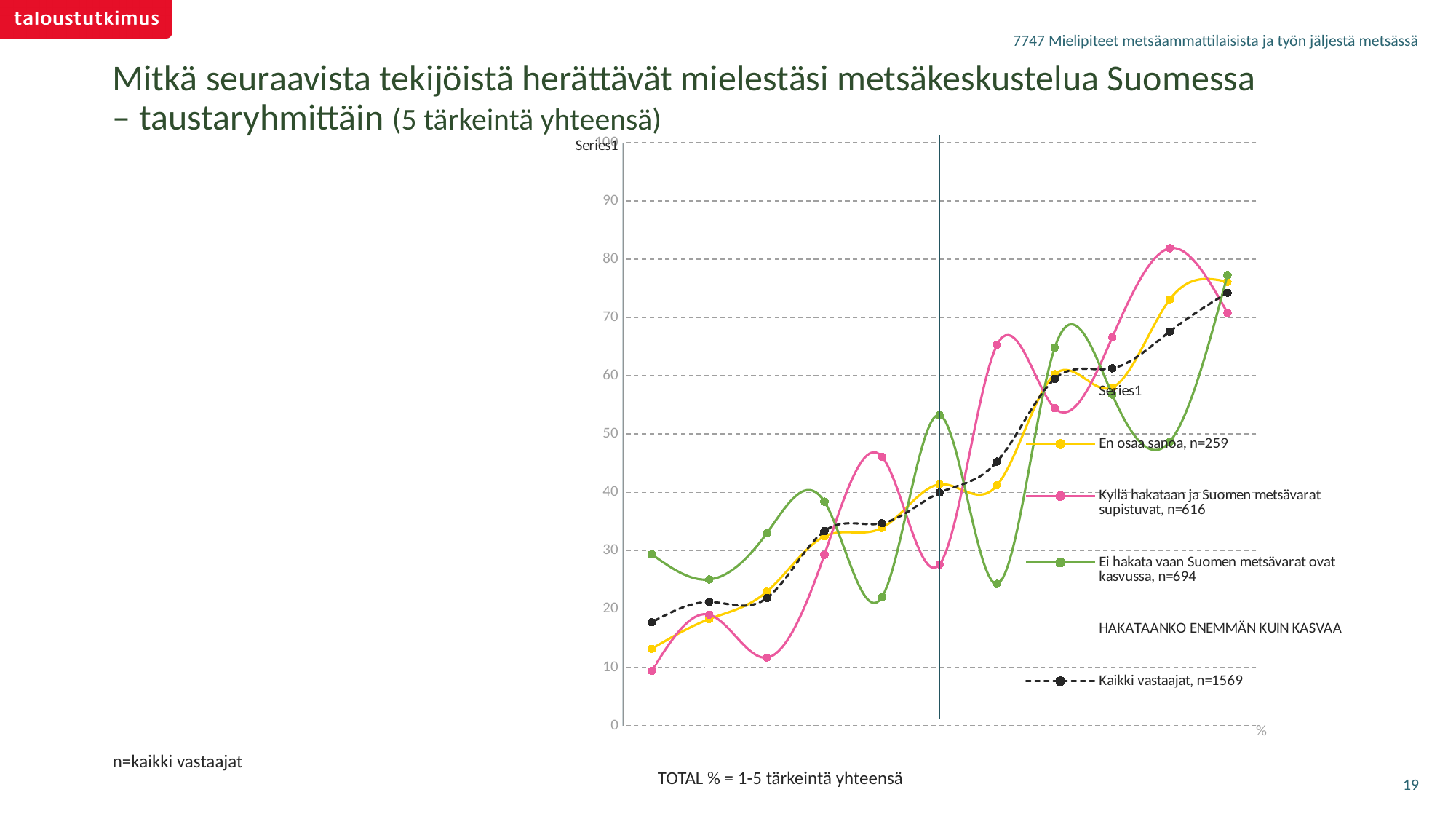
What kind of chart is shown on the slide? line chart Which series reaches the highest value anywhere on the chart? Kyllä hakataan ja Suomen metsävarat supistuvat, n=616 Do the values of the 'Kaikki vastaajat, n=1569' line generally rise or fall from left to right? rise Is the leftmost point of the 'En osaa sanoa, n=259' line greater or less than 10? greater How many data points does each line have? 11 What is the highest value shown on the vertical axis? 100 Is the leftmost point of the 'Kaikki vastaajat, n=1569' line greater or less than 20? less How many data series does the legend list with an n value? 4 What is the sample size (n) given in the legend for the 'Kaikki vastaajat' series? 1569 Is the rightmost point of the 'Ei hakata vaan Suomen metsävarat ovat kasvussa, n=694' line greater or less than 70? greater At the leftmost point, which series has the larger value: 'Ei hakata vaan Suomen metsävarat ovat kasvussa, n=694' or 'En osaa sanoa, n=259'? Ei hakata vaan Suomen metsävarat ovat kasvussa, n=694 Which series has the lowest value anywhere on the chart? Kyllä hakataan ja Suomen metsävarat supistuvat, n=616